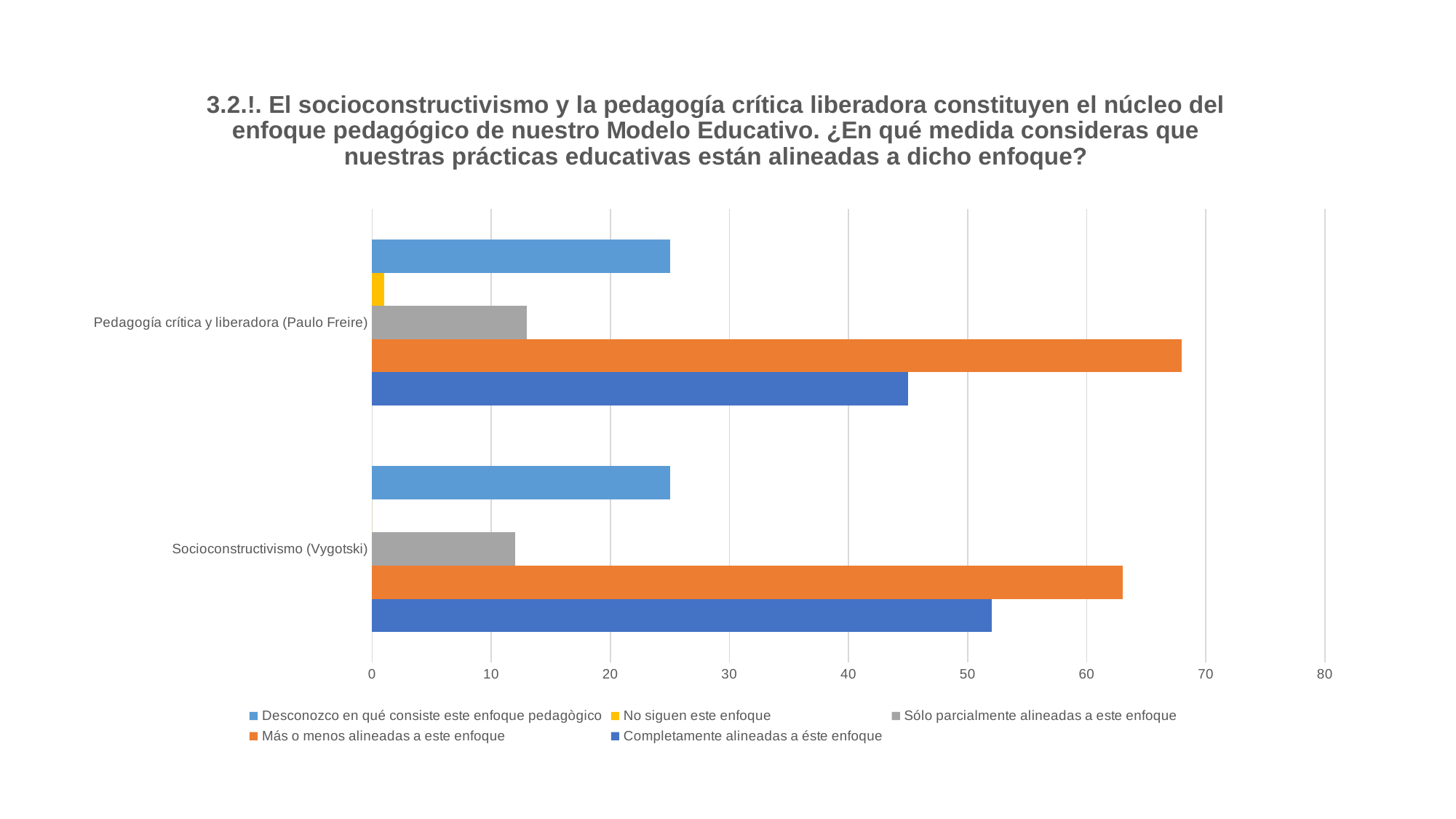
Is the value for Completamente alineadas a éste enfoque for Socioconstructivismo (Vygotski) greater or less than 50? greater What kind of chart is shown on the slide? bar chart Which is larger: Completamente alineadas a éste enfoque for Pedagogía crítica y liberadora (Paulo Freire) or for Socioconstructivismo (Vygotski)? Socioconstructivismo (Vygotski) How many categories are shown on the vertical axis of the chart? 2 Is the value for Sólo parcialmente alineadas a este enfoque for Socioconstructivismo (Vygotski) greater or less than 20? less Is the value for Más o menos alineadas a este enfoque for Pedagogía crítica y liberadora (Paulo Freire) greater or less than 60? greater Which series has the longest bar for Socioconstructivismo (Vygotski)? Más o menos alineadas a este enfoque Which series has the shortest bar for Pedagogía crítica y liberadora (Paulo Freire)? No siguen este enfoque Which series has the longest bar for Pedagogía crítica y liberadora (Paulo Freire)? Más o menos alineadas a este enfoque How many series does the legend list? 5 What colour are the bars for the series Más o menos alineadas a este enfoque? orange Which is larger: Más o menos alineadas a este enfoque for Pedagogía crítica y liberadora (Paulo Freire) or for Socioconstructivismo (Vygotski)? Pedagogía crítica y liberadora (Paulo Freire)